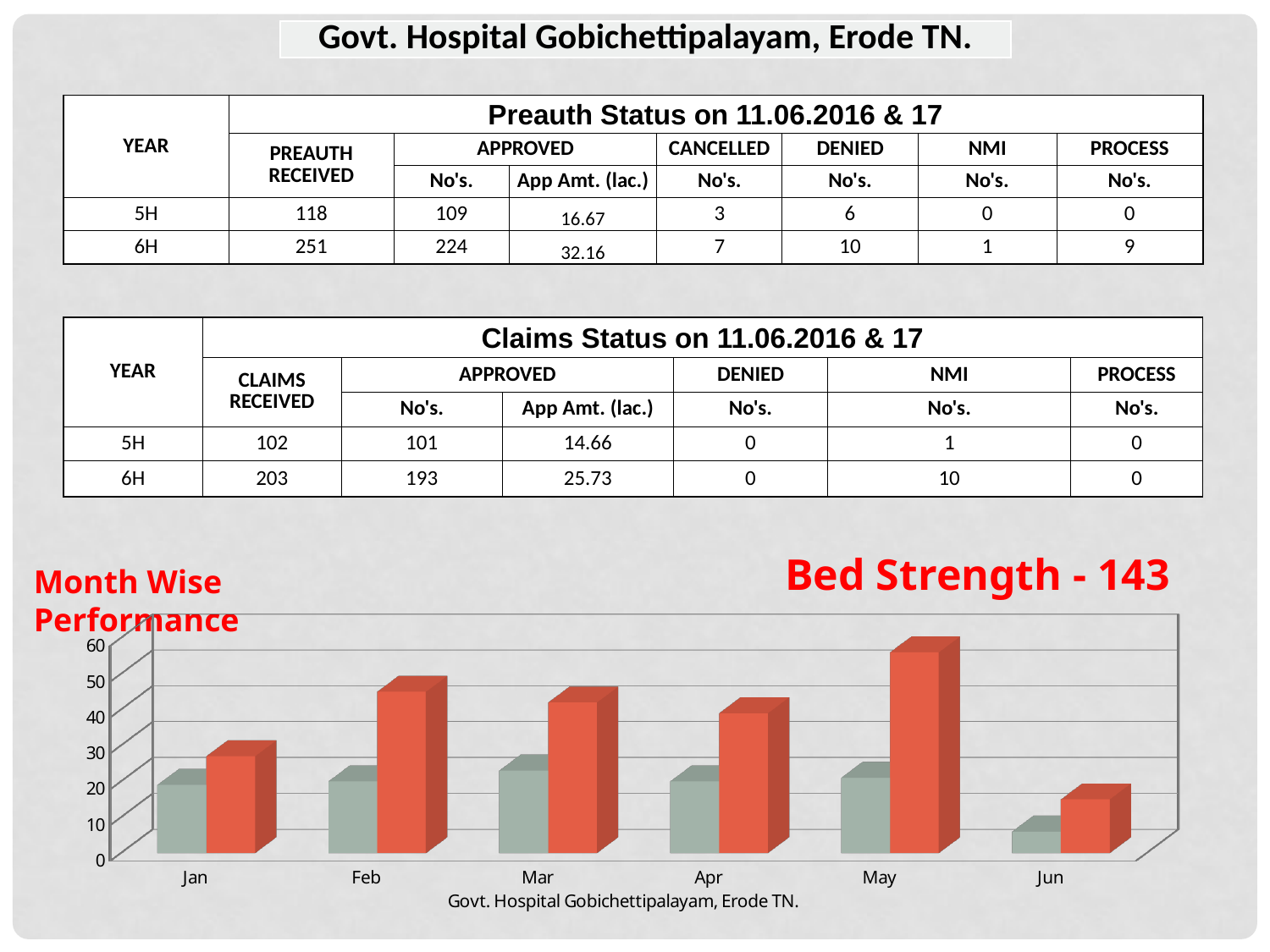
In the Month Wise Performance chart, is the grey bar for Mar greater or less than 30? less What kind of chart is shown at the bottom of the slide? bar chart In the Month Wise Performance chart, is the grey bar for Jun greater or less than 10? less What text appears below the x axis of the Month Wise Performance chart? Govt. Hospital Gobichettipalayam, Erode TN. In the Month Wise Performance chart, which month has the tallest red bar? May In the Month Wise Performance chart, which month has the shortest grey bar? Jun In the Month Wise Performance chart, is the red bar for May greater or less than 50? greater How many months are shown on the x axis of the Month Wise Performance chart? 6 In the Month Wise Performance chart, which month has the shortest red bar? Jun In the Month Wise Performance chart, which is larger: the red bar for May or the red bar for Feb? May In the Month Wise Performance chart, which is larger in May: the red bar or the grey bar? the red bar